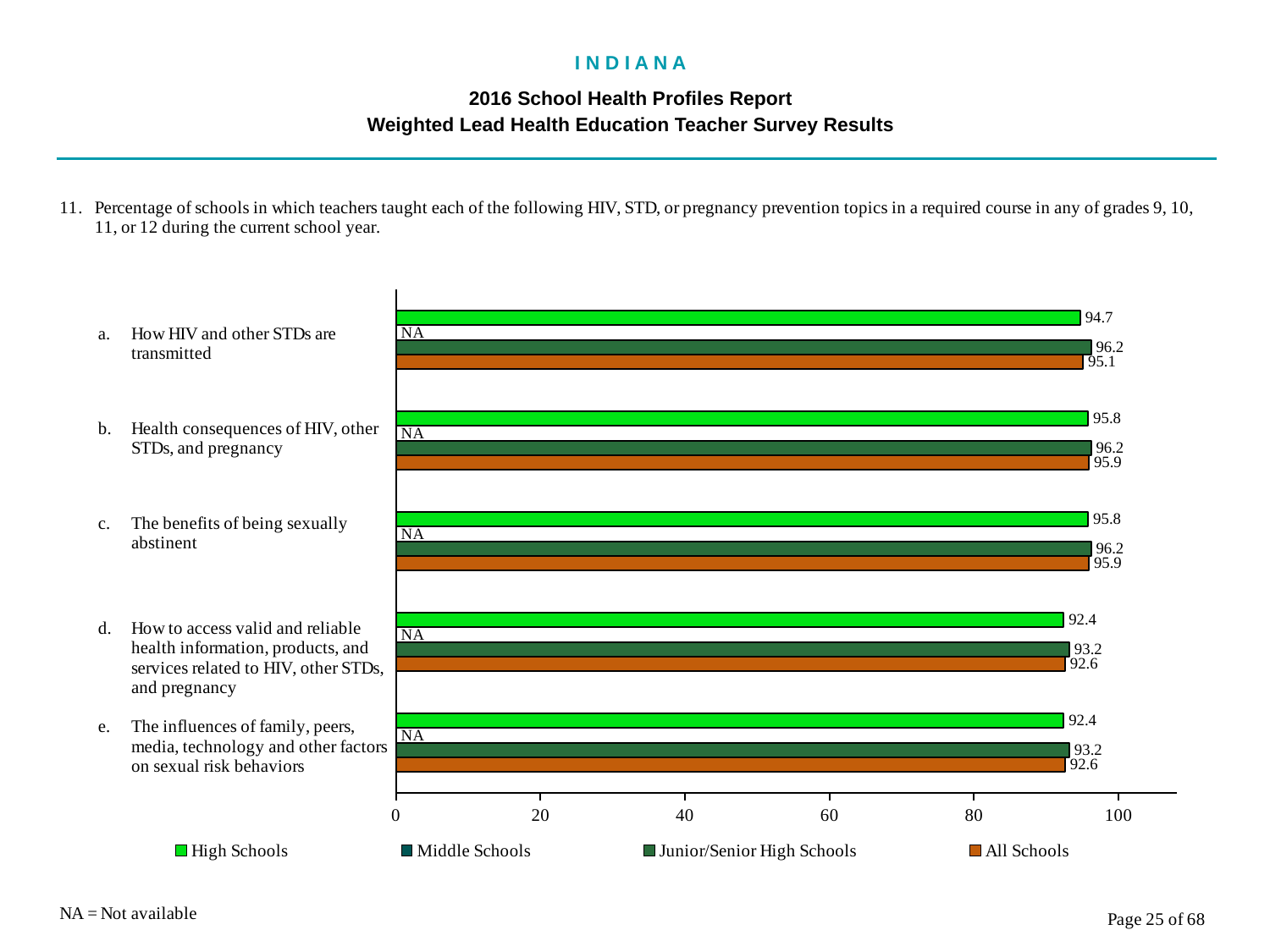
Is the All Schools value for 'How HIV and other STDs are transmitted' greater or less than 80? greater What is the All Schools value for 'The benefits of being sexually abstinent'? 95.9 What is the Junior/Senior High Schools value for 'How to access valid and reliable health information, products, and services related to HIV, other STDs, and pregnancy'? 93.2 How many topics (categories) are shown in the chart? 5 What is the difference between the Junior/Senior High Schools and High Schools values for 'How HIV and other STDs are transmitted'? 1.5 Which is larger for 'The influences of family, peers, media, technology and other factors on sexual risk behaviors': the High Schools value or the Junior/Senior High Schools value? Junior/Senior High Schools What is shown for Middle Schools for 'Health consequences of HIV, other STDs, and pregnancy'? NA What kind of chart is shown on the slide? bar chart How many series does the legend list? 4 What is the High Schools value for 'How HIV and other STDs are transmitted'? 94.7 What does NA stand for according to the note on the slide? Not available